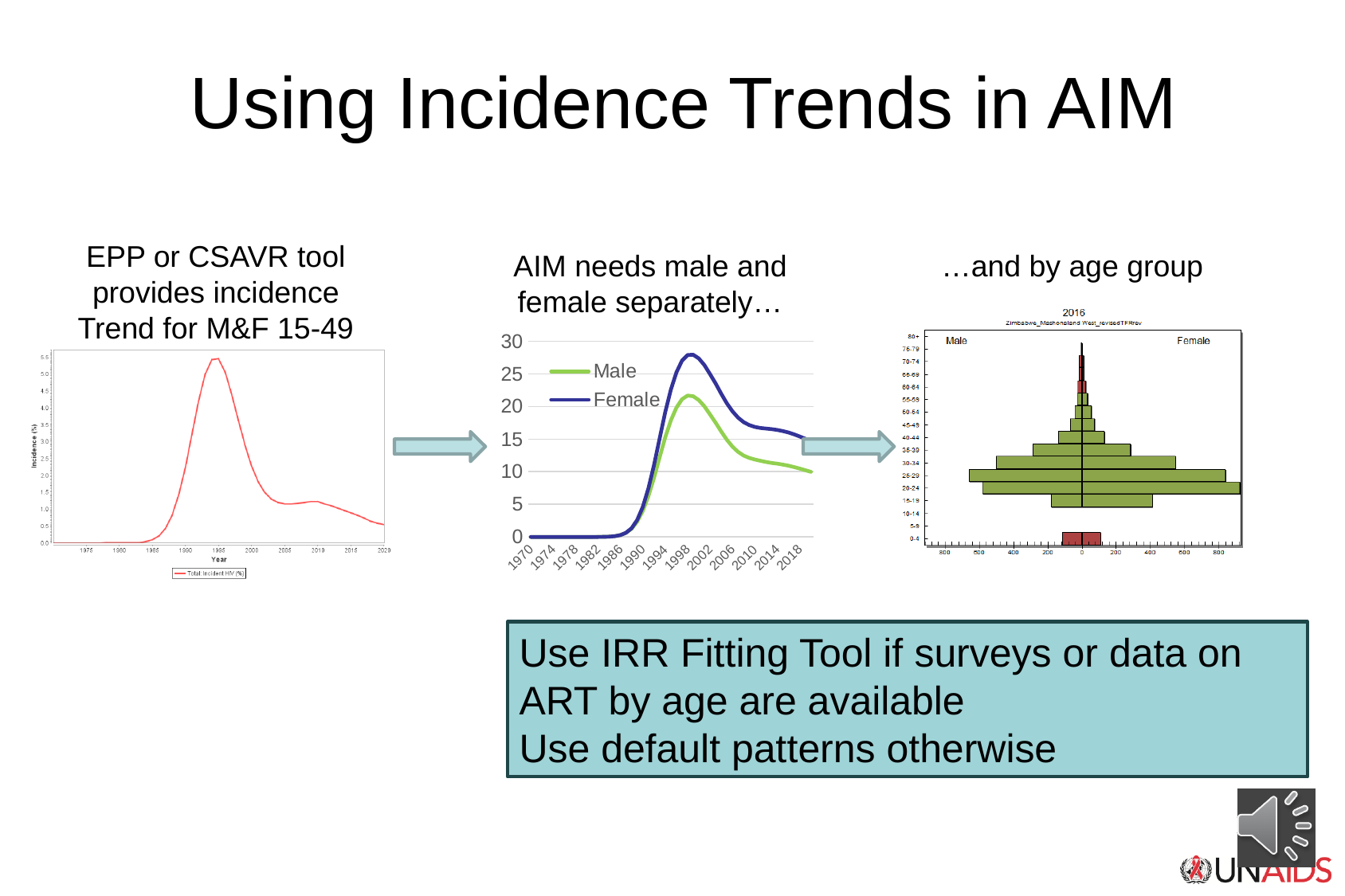
How many series does the legend of the middle chart list? 2 What are the two series named in the legend of the middle chart? Male and Female What kind of chart is the right chart showing data by age group? bar chart What is the label of the y axis on the left chart? Incidence (%) In the right chart, which age group has the longest Female bar? 20-24 In the middle chart, is the peak value of the Female series greater or less than 25? greater In the middle chart, is the peak value of the Male series greater or less than 25? less In the middle chart, which series reaches the higher peak, Male or Female? Female In the middle chart, is the Male value in 2018 greater or less than 15? less What kind of chart is the middle chart titled 'AIM needs male and female separately…'? line chart In the middle chart, do the values rise or fall between 2002 and 2018? fall